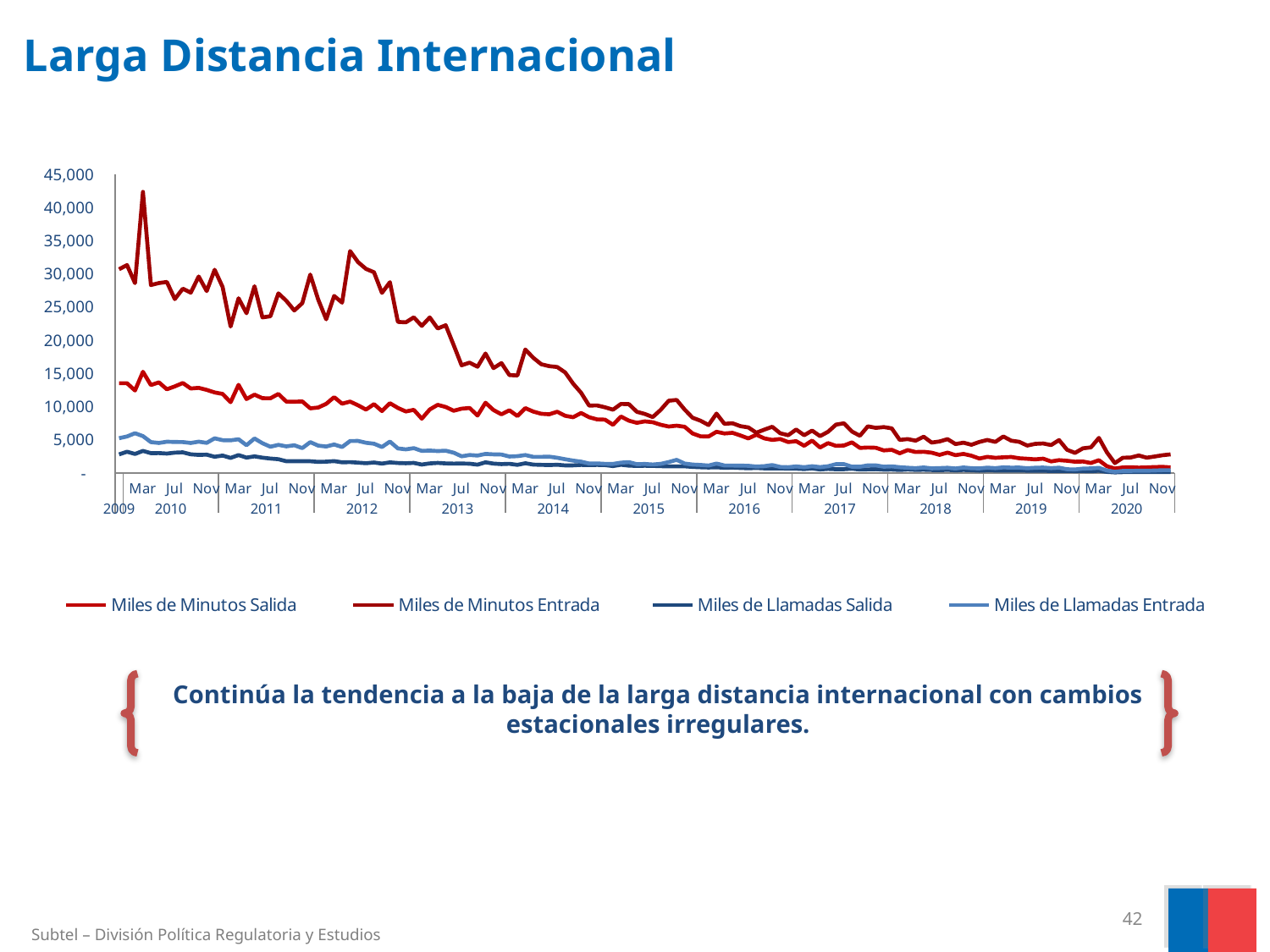
How many series does the legend list? 4 Is the value for Miles de Minutos Entrada in Nov 2020 greater or less than 5,000? less Which is larger in 2010, Miles de Minutos Entrada or Miles de Minutos Salida? Miles de Minutos Entrada What kind of chart is shown on the slide? line chart Is the peak value for Miles de Minutos Entrada in 2009 greater or less than 40,000? less What is the title of the slide containing the chart? Larga Distancia Internacional Do the values for Miles de Minutos Entrada rise or fall from 2009 to 2020? fall How many years are labelled on the x axis? 12 Is the value for Miles de Minutos Salida at the start of 2009 greater or less than 10,000? greater What is the highest value shown on the y axis? 45,000 Do the values for Miles de Minutos Salida rise or fall from 2009 to 2020? fall Which series has the highest values across the chart? Miles de Minutos Entrada